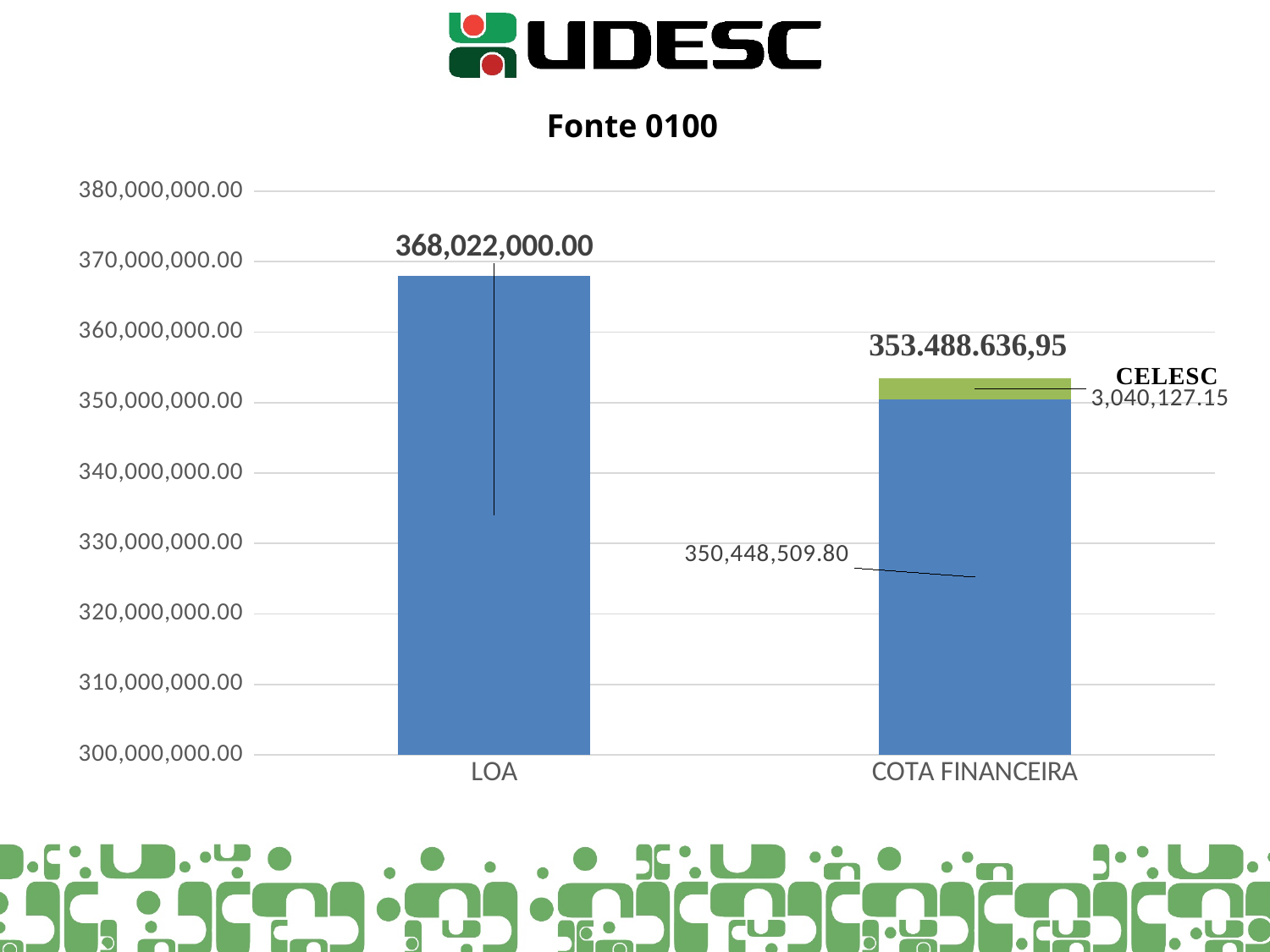
What is the value of the CELESC portion of the COTA FINANCEIRA bar? 3,040,127.15 How many categories are shown on the x axis? 2 What is the title of the chart? Fonte 0100 What kind of chart is shown on the slide? Bar chart Is the total value for COTA FINANCEIRA greater or less than 360,000,000.00? less What is the total value labelled above the COTA FINANCEIRA bar? 353.488.636,95 Which category has the higher bar, LOA or COTA FINANCEIRA? LOA What is the value of the LOA bar? 368,022,000.00 What is the difference between the LOA value and the blue portion of the COTA FINANCEIRA bar (350,448,509.80)? 17,573,490.20 Which category has the lowest total value? COTA FINANCEIRA What is the value of the blue (lower) portion of the COTA FINANCEIRA bar? 350,448,509.80 Is the value for LOA greater or less than 360,000,000.00? greater